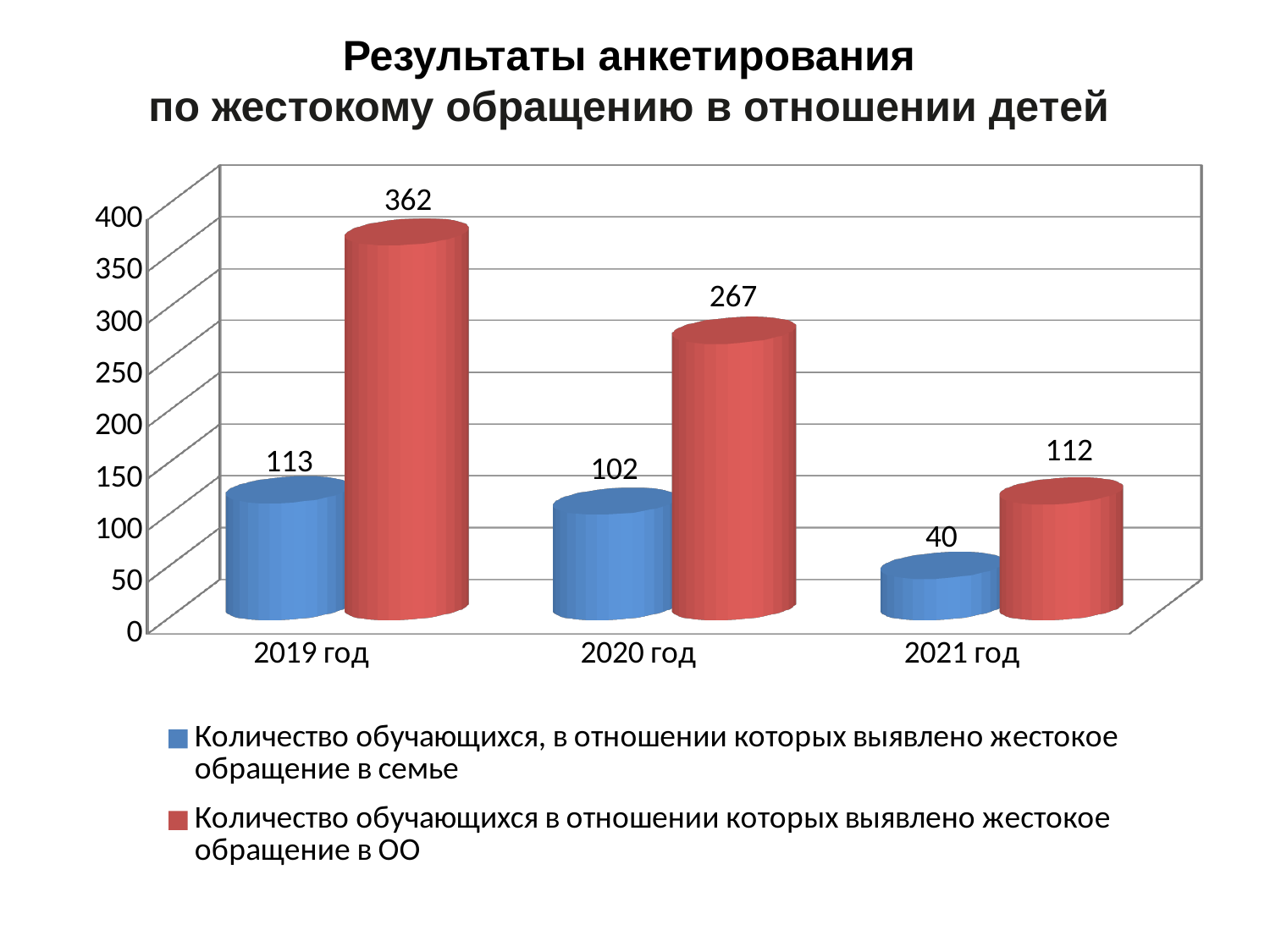
Which year has the highest value for the series 'Количество обучающихся в отношении которых выявлено жестокое обращение в ОО'? 2019 год How many years are shown on the x axis? 3 Which is larger in 2021 год: the 'в семье' value or the 'в ОО' value? в ОО (112) Which year has the lowest value for the series 'Количество обучающихся, в отношении которых выявлено жестокое обращение в семье'? 2021 год What is the difference between the two series' values in 2019 год? 249 Do the values for the series 'Количество обучающихся в отношении которых выявлено жестокое обращение в ОО' rise or fall from 2019 год to 2021 год? Fall What is the value for 2020 год for the series 'Количество обучающихся в отношении которых выявлено жестокое обращение в ОО'? 267 How many series does the legend list? 2 What is the difference between the 'в ОО' values for 2019 год and 2020 год? 95 What is the value for 2021 год for the series 'Количество обучающихся, в отношении которых выявлено жестокое обращение в семье'? 40 What is the value for 2019 год for the series 'Количество обучающихся, в отношении которых выявлено жестокое обращение в семье'? 113 What kind of chart is shown on the slide? Bar chart